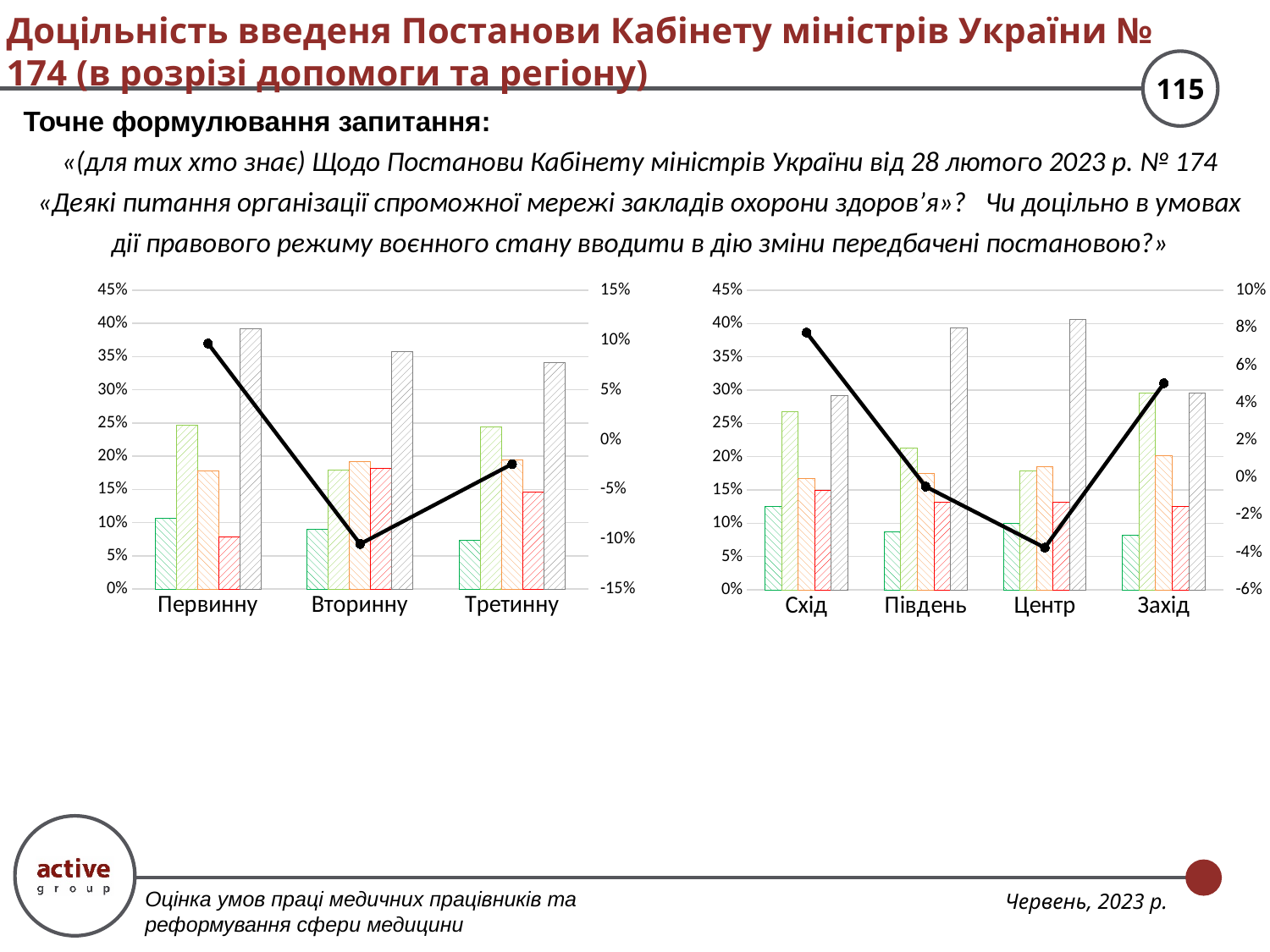
In the left chart, which category has the lowest line value? Вторинну In the left chart, which category has the highest line value? Первинну In the left chart, is the line value for Вторинну (right axis) greater or less than 0%? less In the right chart, how many categories are shown on the x axis? 4 In the right chart, is the line value for Схід (right axis) greater or less than 6%? greater In the left chart, is the line value for Первинну (right axis) greater or less than 5%? greater In the right chart, which category has the highest line value? Схід In the right chart, does the line rise or fall from Центр to Захід? rises In the left chart, how many categories are shown on the x axis? 3 What kind of chart is the left chart? A combined bar and line chart In the right chart, which category has the lowest line value? Центр In the right chart, what is the highest tick shown on the right-hand axis? 10%